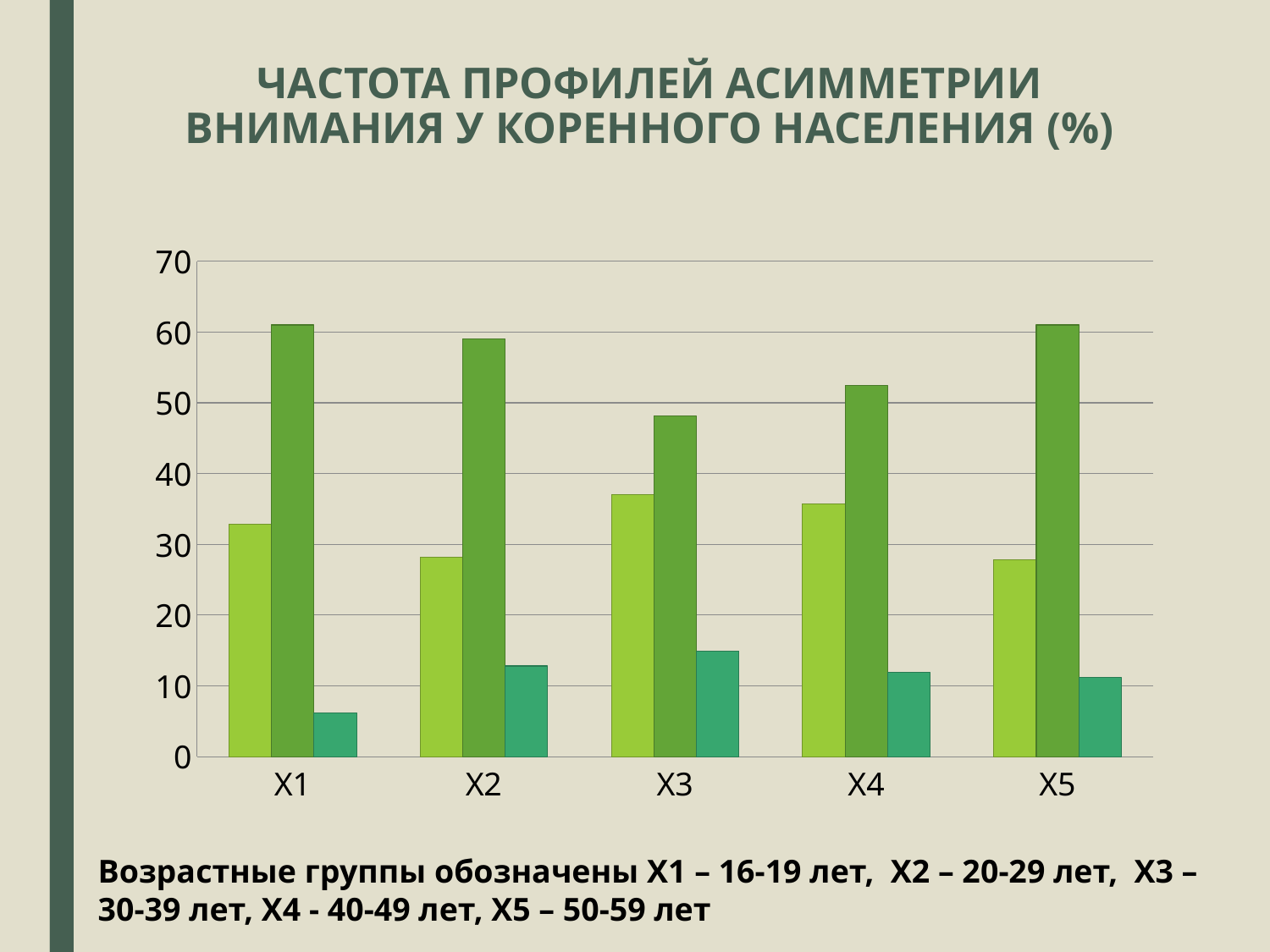
How many bars are plotted for each category? 3 Which category has the lowest teal bar? X1 Is the value of the light green bar for X3 greater or less than 40? less Which category has the lowest dark green bar? X3 Is the value of the dark green bar for X1 greater or less than 50? greater What kind of chart is shown on the slide? bar chart Which is larger for X1: the light green bar or the teal bar? the light green bar What is the title of the chart? ЧАСТОТА ПРОФИЛЕЙ АСИММЕТРИИ ВНИМАНИЯ У КОРЕННОГО НАСЕЛЕНИЯ (%) Is the value of the teal bar for X1 greater or less than 10? less How many categories are shown on the x axis? 5 Which dark green bar is larger: X1 or X3? X1